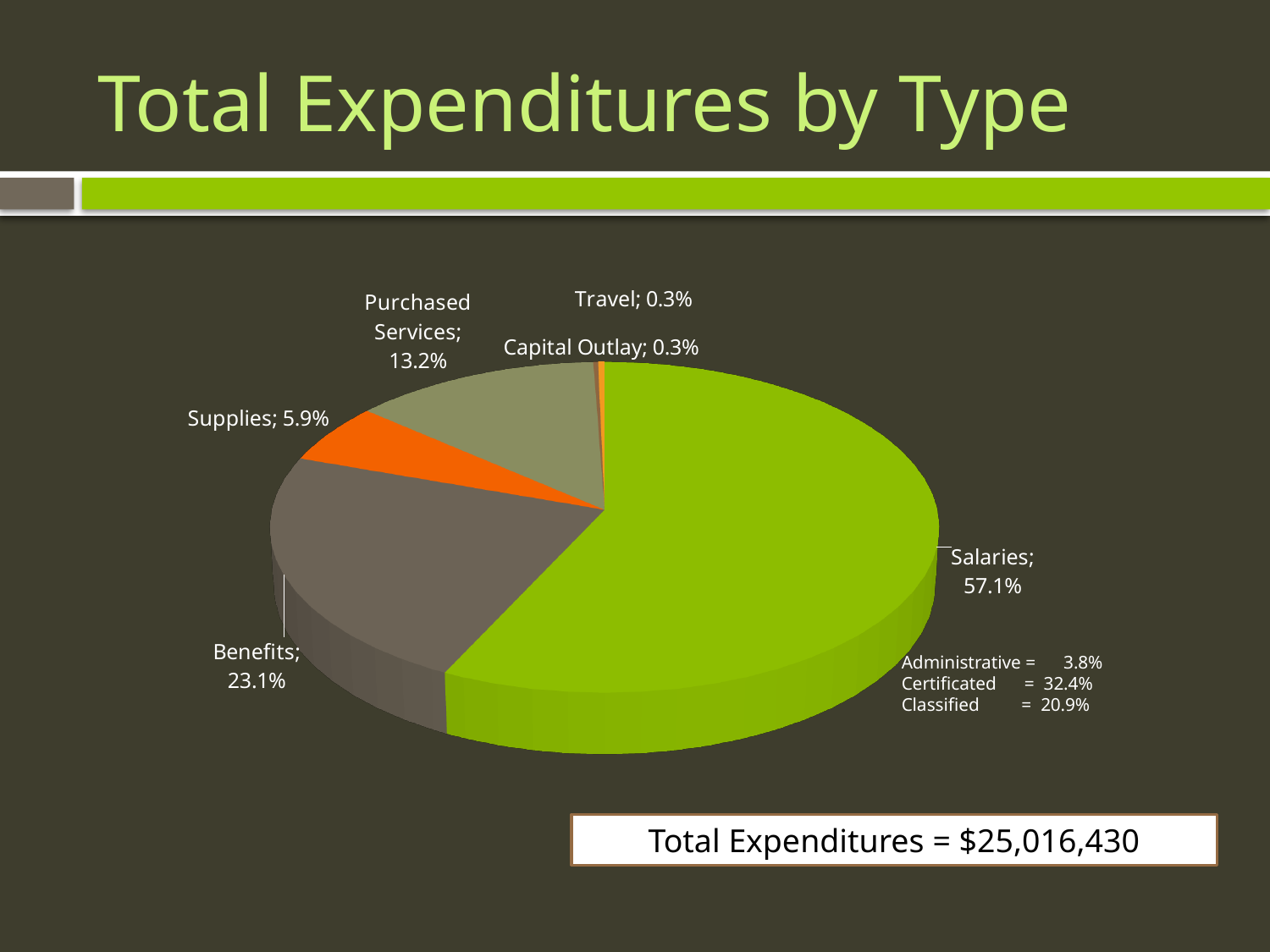
What share of total expenditures is Purchased Services? 13.2% Which expenditure type has the largest share of the pie? Salaries What is the title of the chart on the slide? Total Expenditures by Type Which is larger, the share for Purchased Services or the share for Supplies? Purchased Services What is the total expenditures amount shown on the slide? $25,016,430 What share of total expenditures is Salaries? 57.1% What share of total expenditures is Benefits? 23.1% What is the difference in percentage points between Salaries and Benefits? 34.0 What share of total expenditures is Supplies? 5.9% What kind of chart is shown on the slide? Pie chart What share of total expenditures is Capital Outlay? 0.3% How many expenditure types are shown as slices in the pie chart? 6